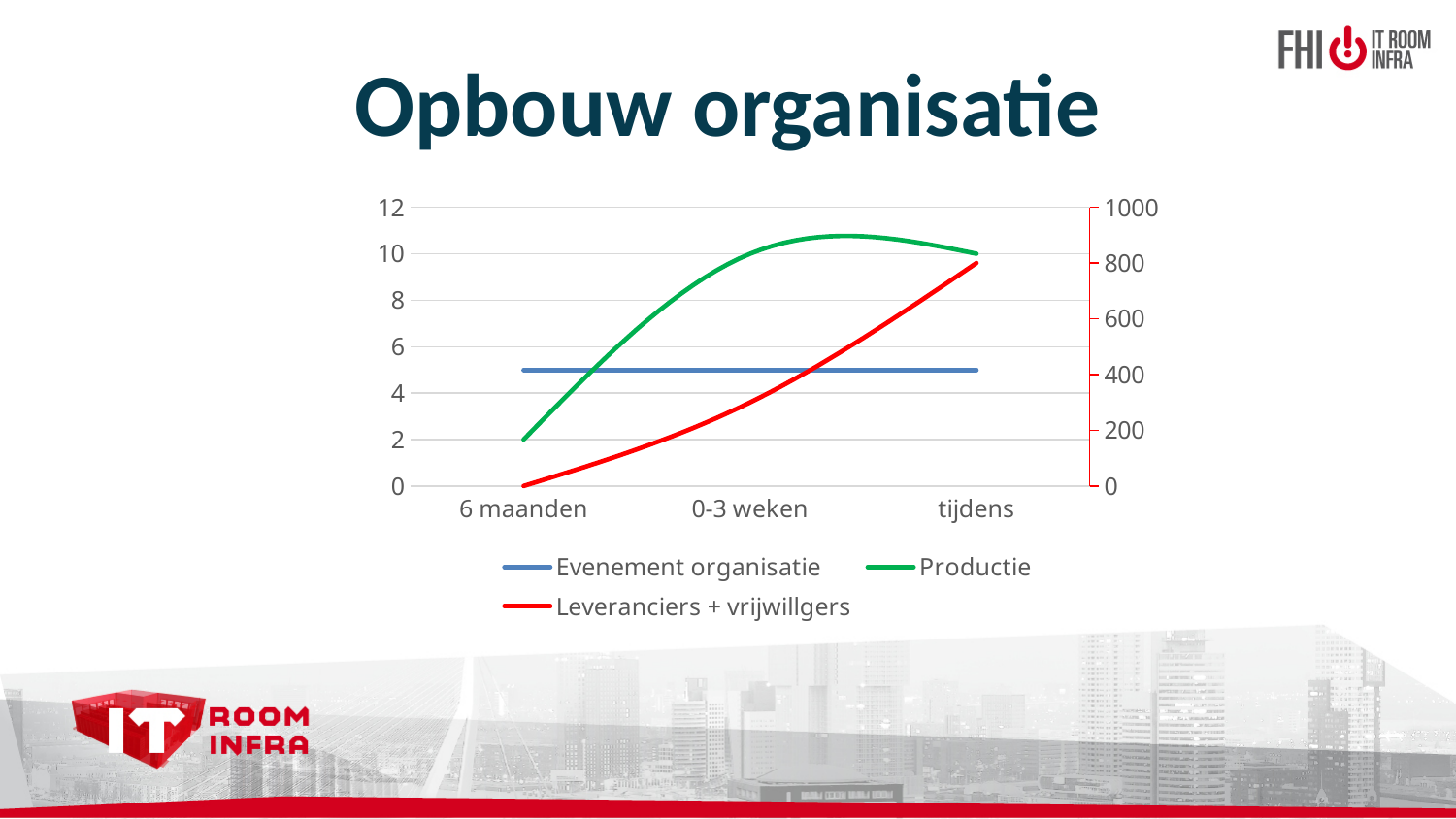
What is the value of Productie at tijdens? 10 Is the value for Evenement organisatie at 0-3 weken greater or less than 4 on the left axis? greater What is the value of Productie at 6 maanden? 2 At tijdens, which series has the lowest value? Evenement organisatie How many categories are shown on the x axis? 3 What is the title of the slide? Opbouw organisatie How many series does the legend list? 3 At 6 maanden, which series has the lowest value? Leveranciers + vrijwilligers Does the Leveranciers + vrijwilligers line rise or fall along the x axis? rise Does the Productie line rise or fall from 6 maanden to tijdens? rise What type of chart is shown on the slide? line chart What is the value of Leveranciers + vrijwilligers at 6 maanden? 0